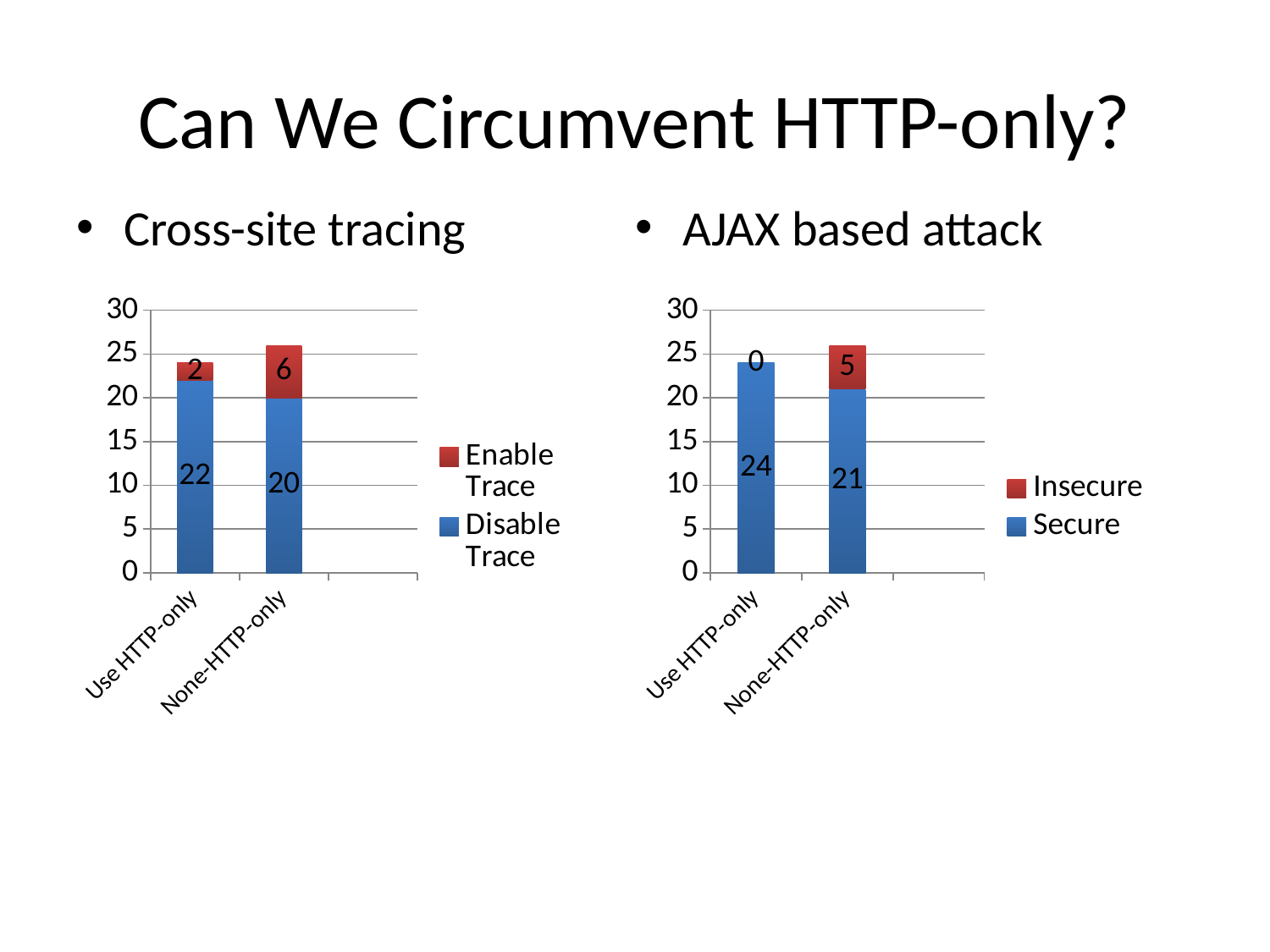
In the right chart (AJAX based attack), what is the total of the stacked bar for Use HTTP-only? 24 In the right chart (AJAX based attack), which colour represents the Secure series? Blue In the left chart (Cross-site tracing), what is the total of the stacked bar for None-HTTP-only? 26 In the left chart (Cross-site tracing), what is the Enable Trace value for None-HTTP-only? 6 In the right chart (AJAX based attack), what is the Insecure value for Use HTTP-only? 0 In the left chart (Cross-site tracing), how many series does the legend list? 2 In the right chart (AJAX based attack), which category has the higher Insecure value? None-HTTP-only In the right chart (AJAX based attack), how many categories are shown on the x axis? 2 In the right chart (AJAX based attack), what is the Secure value for None-HTTP-only? 21 In the left chart (Cross-site tracing), what is the difference between the Enable Trace values for None-HTTP-only and Use HTTP-only? 4 In the left chart (Cross-site tracing), what is the Disable Trace value for Use HTTP-only? 22 What kind of chart is the left chart (Cross-site tracing)? Stacked bar chart